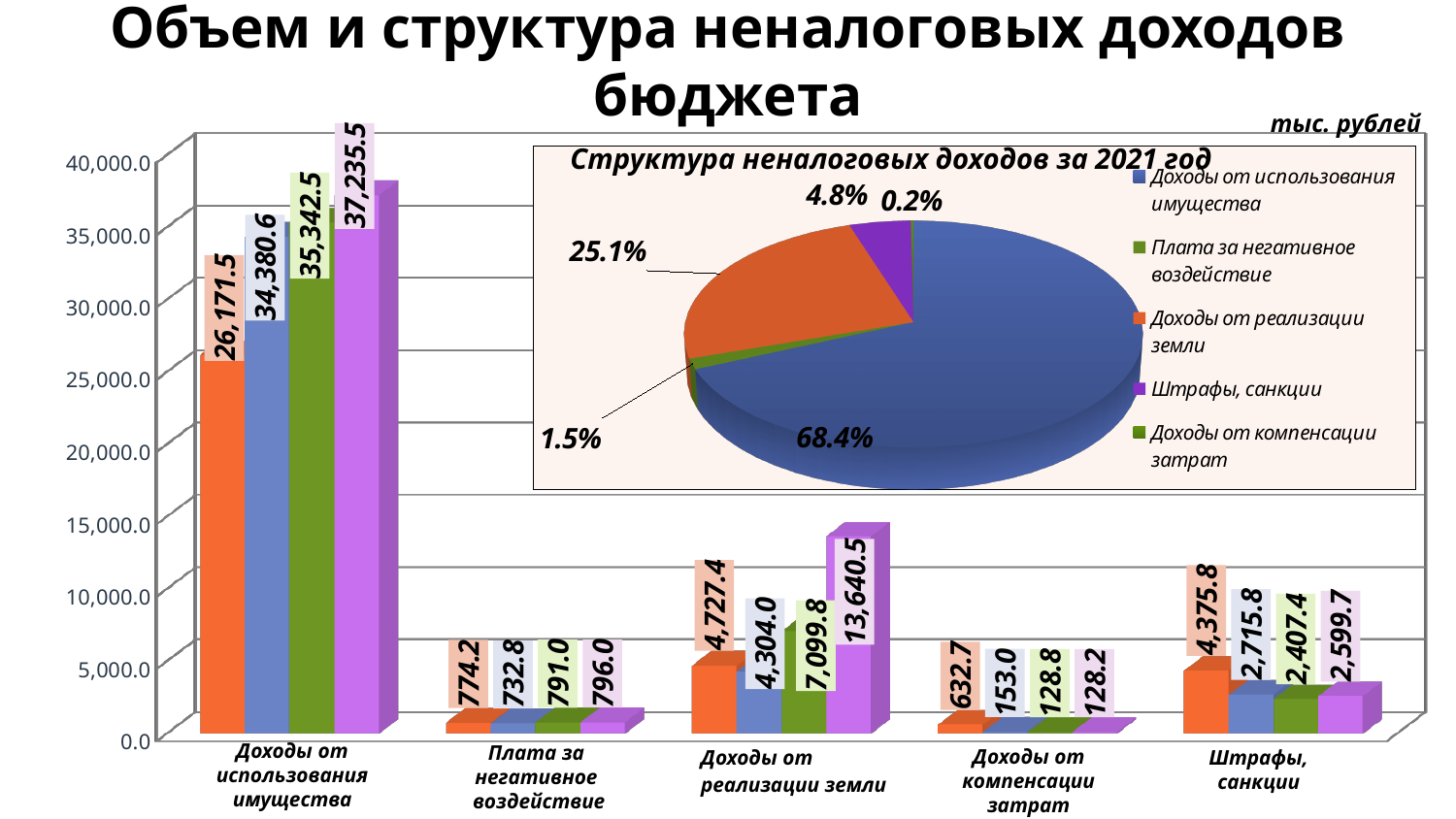
On the bar chart, what is the value of the purple bar for Доходы от использования имущества? 37,235.5 On the bar chart, how many categories are shown on the x axis? 5 On the pie chart, what share does Доходы от реализации земли have? 25.1% On the bar chart, which category has the highest values overall? Доходы от использования имущества On the pie chart, what share does Доходы от использования имущества have? 68.4% On the bar chart, what is the value of the orange bar for Доходы от реализации земли? 4,727.4 On the bar chart, which is larger for Штрафы, санкции: the orange bar or the blue bar? the orange bar (4,375.8) On the bar chart, what is the value of the green bar for Штрафы, санкции? 2,407.4 How many entries does the legend of the pie chart list? 5 What is the title of the pie chart? Структура неналоговых доходов за 2021 год On the bar chart, what is the difference between the purple and orange bars for Доходы от реализации земли? 8,913.1 On the bar chart, do the values for Плата за негативное воздействие rise or fall from the orange bar to the purple bar? rise